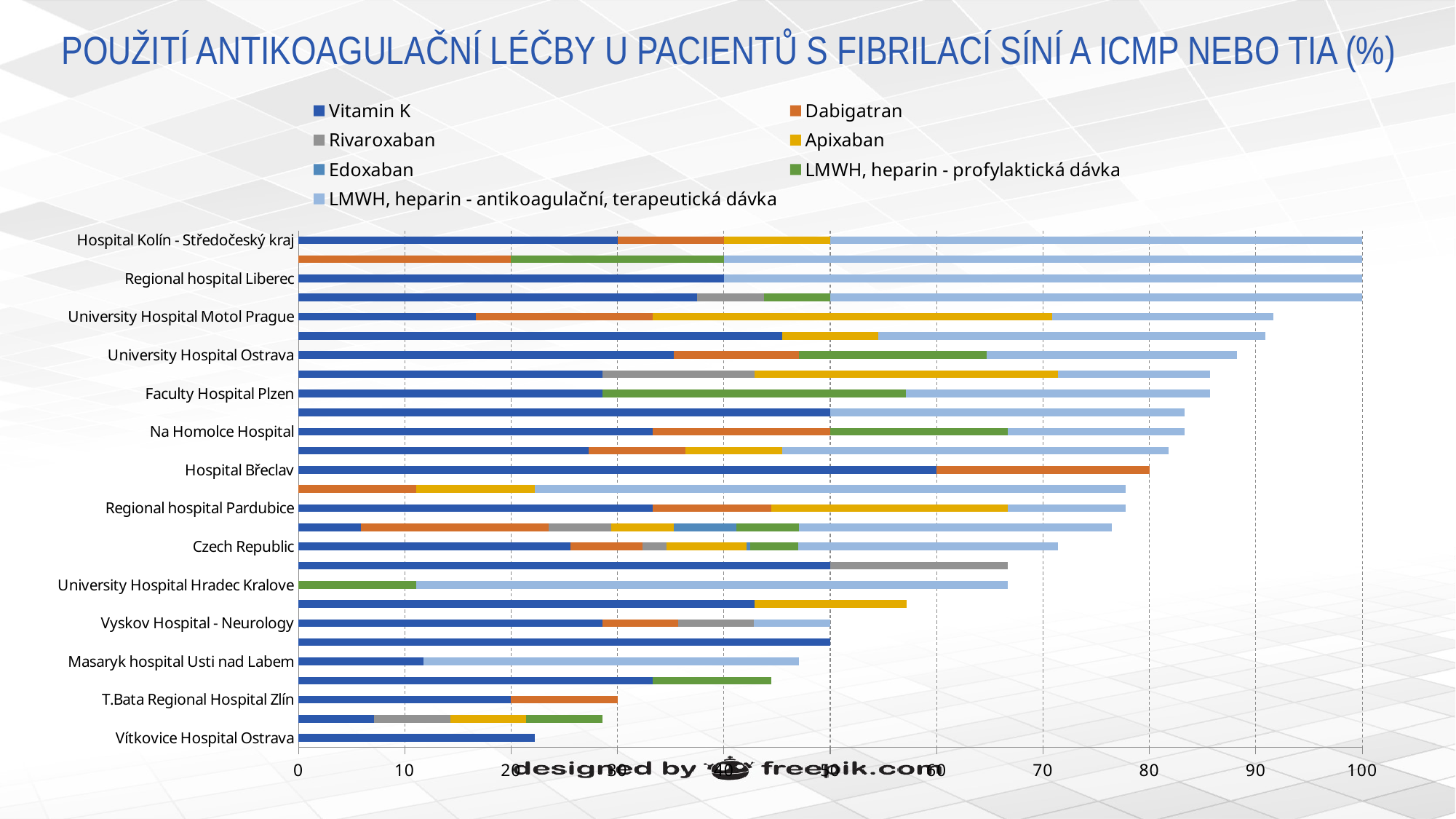
Which has the longer total bar: Regional hospital Liberec or University Hospital Motol Prague? Regional hospital Liberec What is the maximum value shown on the horizontal axis? 100 Which has the longer total bar: Hospital Břeclav or Czech Republic? Hospital Břeclav Is the Vitamin K segment for Hospital Břeclav greater or less than 50? greater How many hospital/category labels are shown on the vertical axis? 14 Which labeled hospital has the shortest total bar? Vítkovice Hospital Ostrava What kind of chart is shown on the slide? Stacked horizontal bar chart Is the total bar length for Czech Republic greater or less than 70? greater How many series does the legend list? 7 Which series is shown in dark blue in the legend? Vitamin K Is the total bar length for Masaryk hospital Usti nad Labem greater or less than 50? less